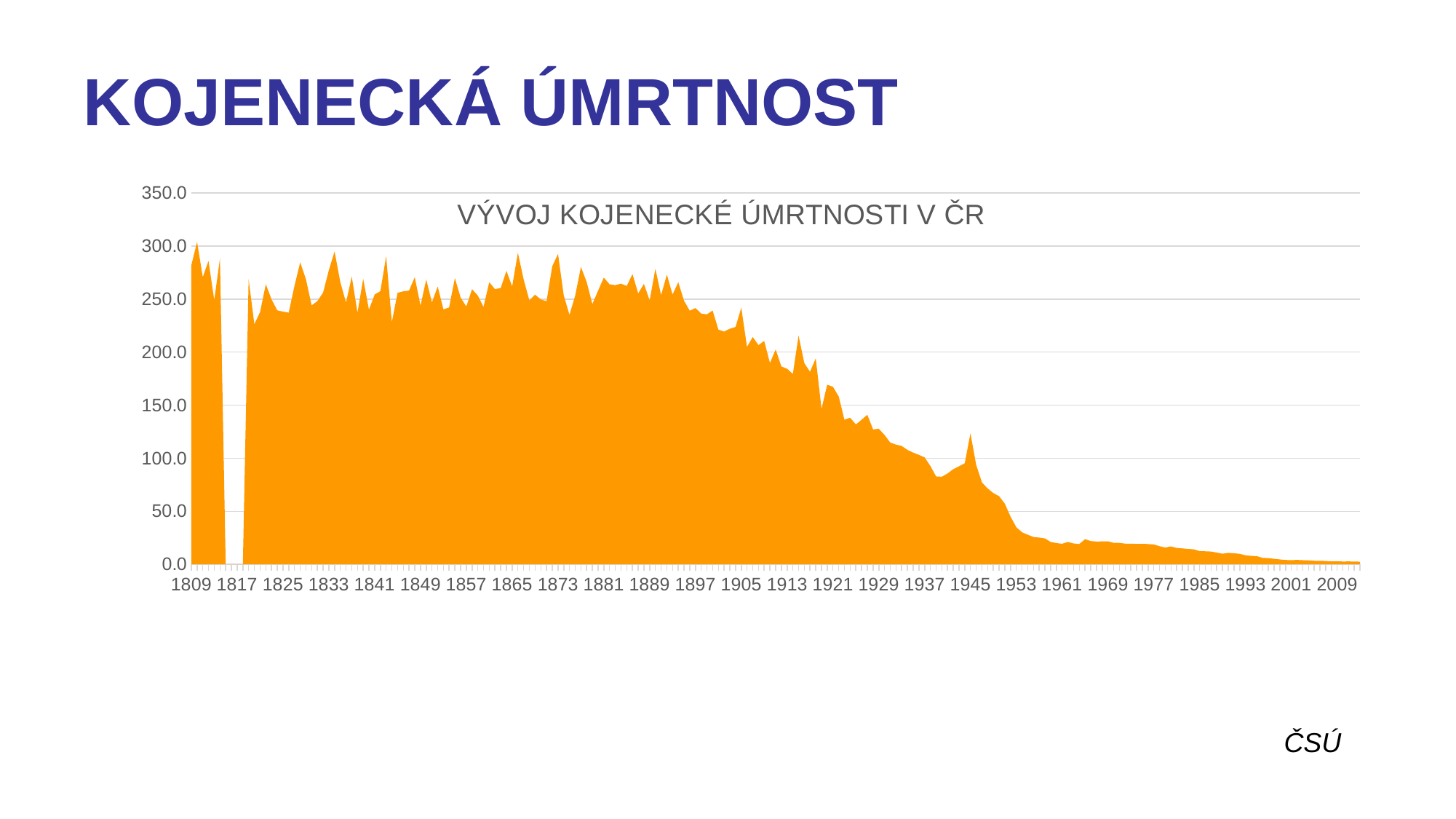
What is the highest value shown on the y axis? 350.0 What is the title of the chart? VÝVOJ KOJENECKÉ ÚMRTNOSTI V ČR Is the value for 1921 greater or less than 100? greater Overall, do the values rise or fall from 1809 to 2009 along the x axis? fall Is the value for 1961 greater or less than 50? less What is the first year labelled on the x axis? 1809 Is the value for 2009 greater or less than 50? less What kind of chart is shown on the slide? area chart Which is larger, the value for 1881 or the value for 1929? 1881